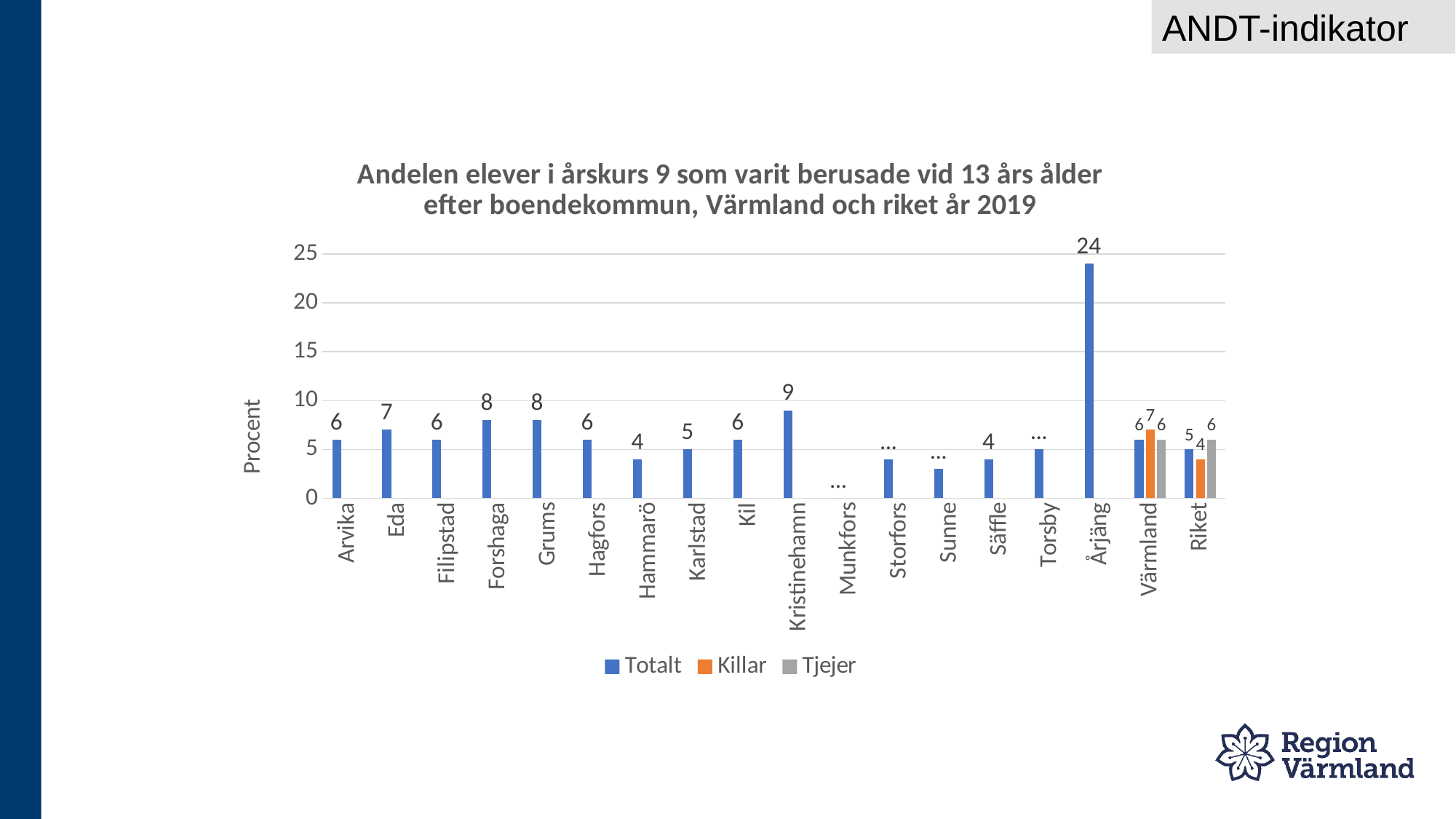
What is the Tjejer value for Riket? 6 What is the Killar value for Värmland? 7 What is the Totalt value for Kristinehamn? 9 Which category has the highest Totalt value? Årjäng How many series does the legend list? 3 What is the label on the vertical axis? Procent What is the Totalt value for Hammarö? 4 What is the Totalt value for Årjäng? 24 Is the Totalt value for Årjäng greater or less than 20? greater What is the difference between the Totalt values for Årjäng and Kristinehamn? 15 Which has a higher Totalt value, Forshaga or Hammarö? Forshaga What kind of chart is shown on the slide? bar chart